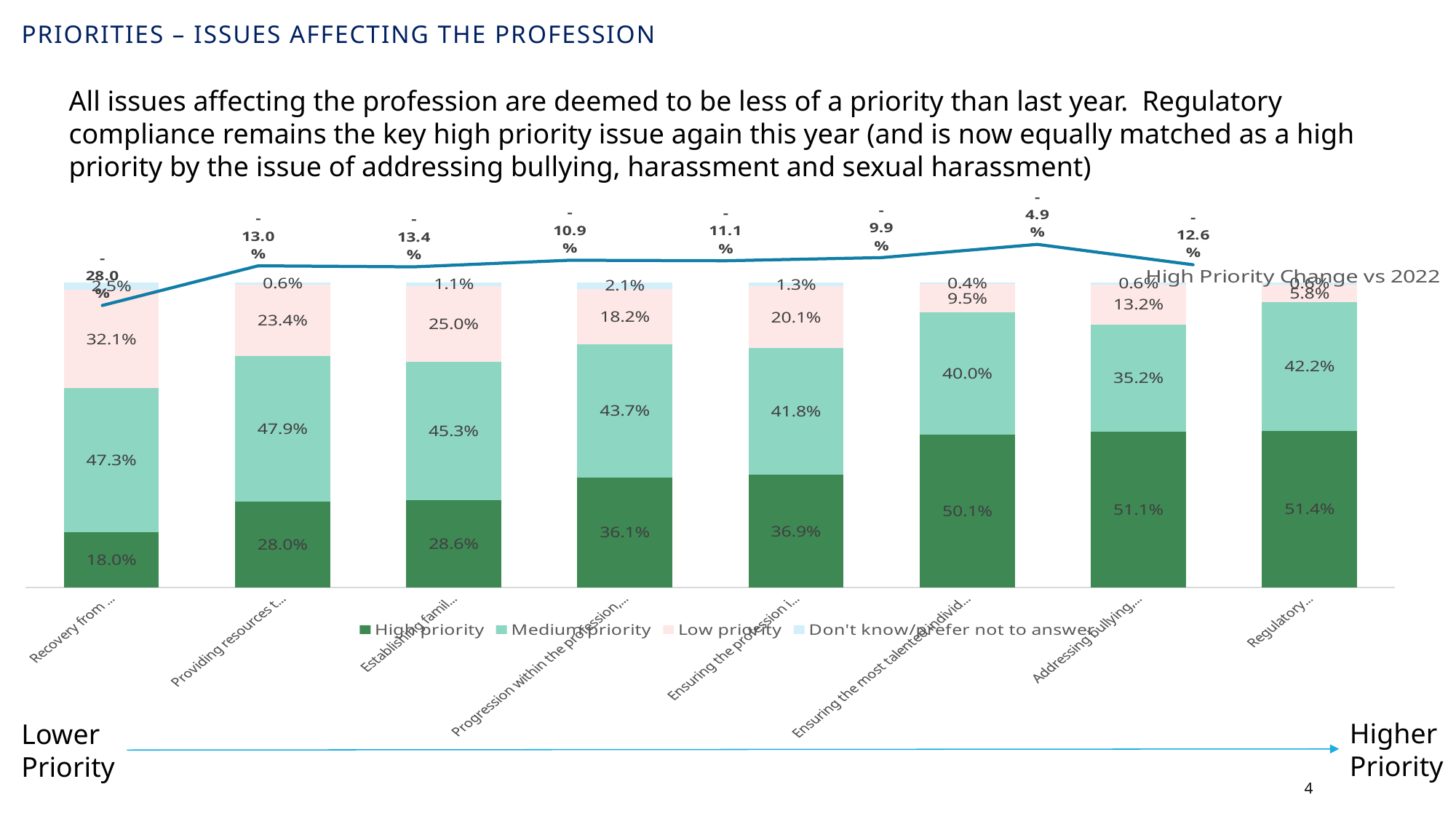
Do the High priority values generally rise or fall from left to right across the bars? Rise Which has a larger Low priority value: 'Recovery from ...' or 'Regulatory...'? Recovery from ... How many bars (categories) are shown in the chart? 8 What is the difference between the High priority values for 'Regulatory...' and 'Recovery from ...'? 33.4% What is the High priority value for the 'Regulatory...' bar? 51.4% What is the High Priority Change vs 2022 value shown above the 'Recovery from ...' bar? -28.0% What kind of chart is this? Stacked bar chart with a line What is the Low priority value for the 'Recovery from ...' bar? 32.1% What is the Medium priority value for the 'Ensuring the most talented individ...' bar? 40.0% Which category has the lowest High priority value? Recovery from ... Which category has the highest Low priority value? Recovery from ... How many series does the legend list? 4